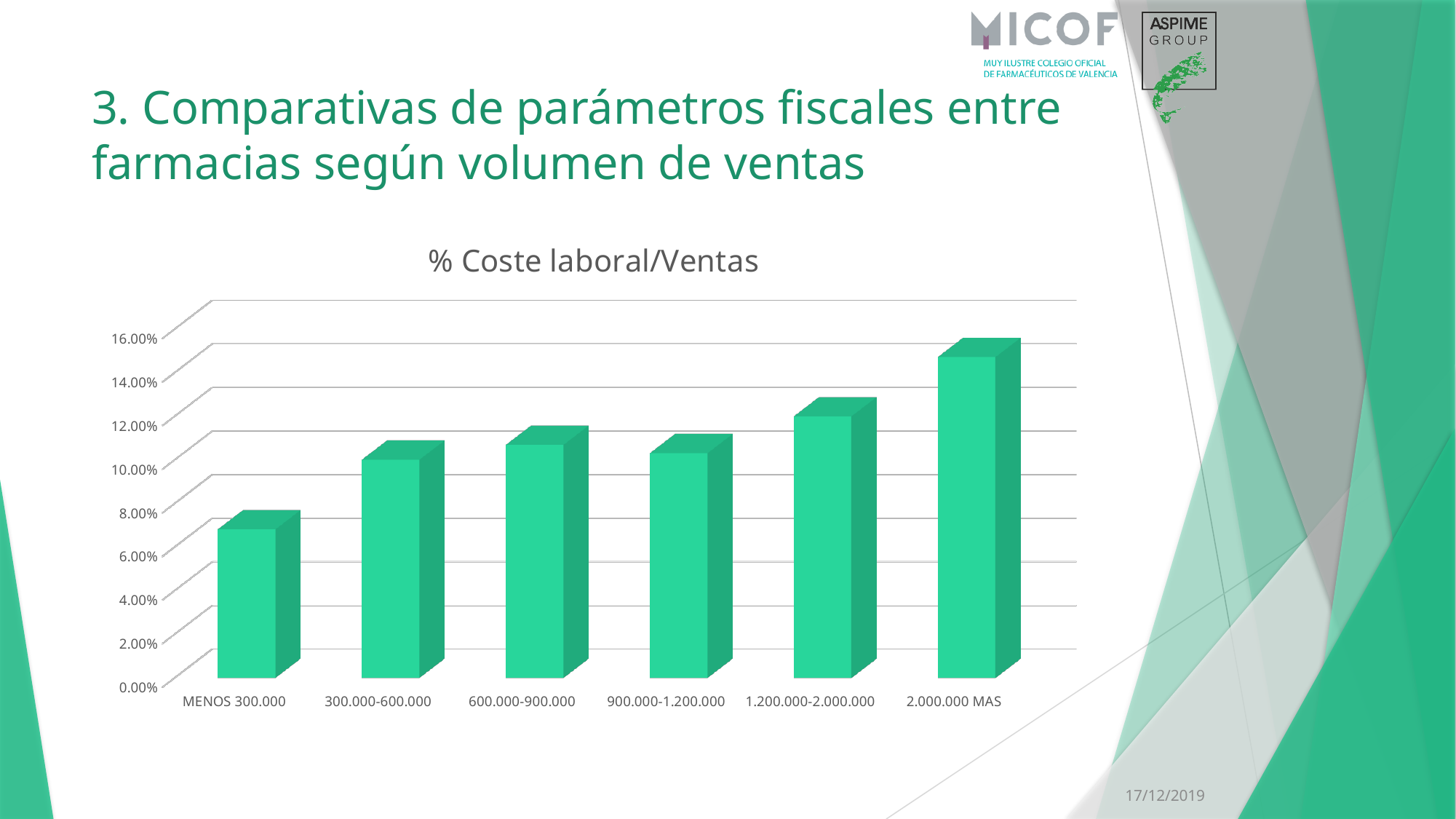
Is the value for 900.000-1.200.000 greater or less than 12.00%? less Which has a lower % Coste laboral/Ventas: MENOS 300.000 or 300.000-600.000? MENOS 300.000 Which category has the lowest % Coste laboral/Ventas? MENOS 300.000 Is the value for 600.000-900.000 greater or less than 10.00%? greater Which has a higher % Coste laboral/Ventas: 1.200.000-2.000.000 or 900.000-1.200.000? 1.200.000-2.000.000 What kind of chart is shown on the slide? Bar chart Is the value for MENOS 300.000 greater or less than 8.00%? less Which category has the highest % Coste laboral/Ventas? 2.000.000 MAS How many sales-volume categories are shown on the x axis of the chart? 6 What is the title of the chart? % Coste laboral/Ventas What colour are the bars in the chart? Green